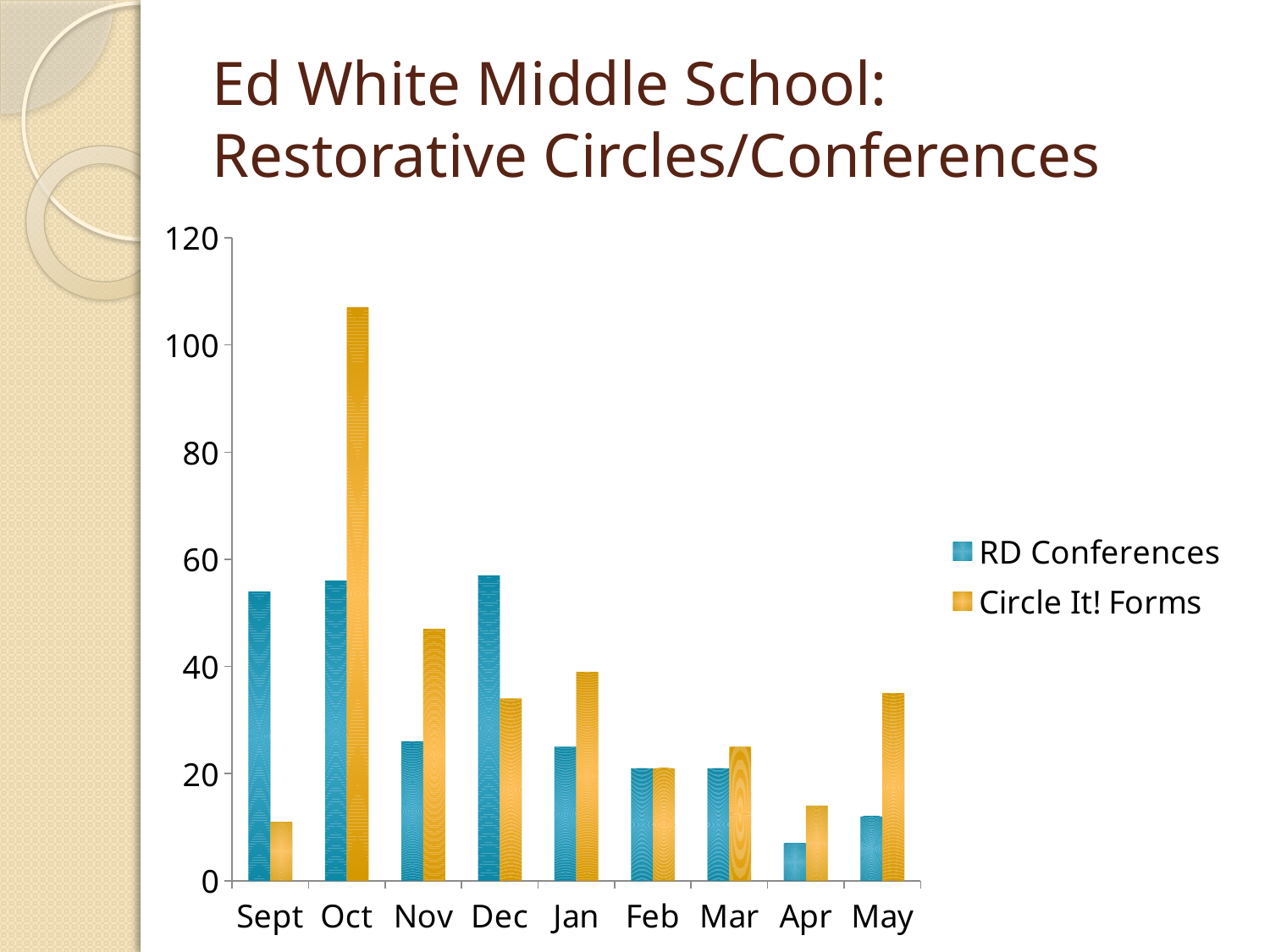
In which month is the RD Conferences value lowest? Apr Which colour represents Circle It! Forms in the legend? Orange/gold How many months are shown on the x axis? 9 What kind of chart is shown on the slide? Bar chart In which month is the Circle It! Forms value highest? Oct Is the RD Conferences value for Apr greater or less than 20? less Is the RD Conferences value for Sept greater or less than 40? greater In Nov, which series has the larger value, RD Conferences or Circle It! Forms? Circle It! Forms Is the Circle It! Forms value for Nov greater or less than 40? greater How many series does the legend list? 2 In Sept, which series has the larger value, RD Conferences or Circle It! Forms? RD Conferences